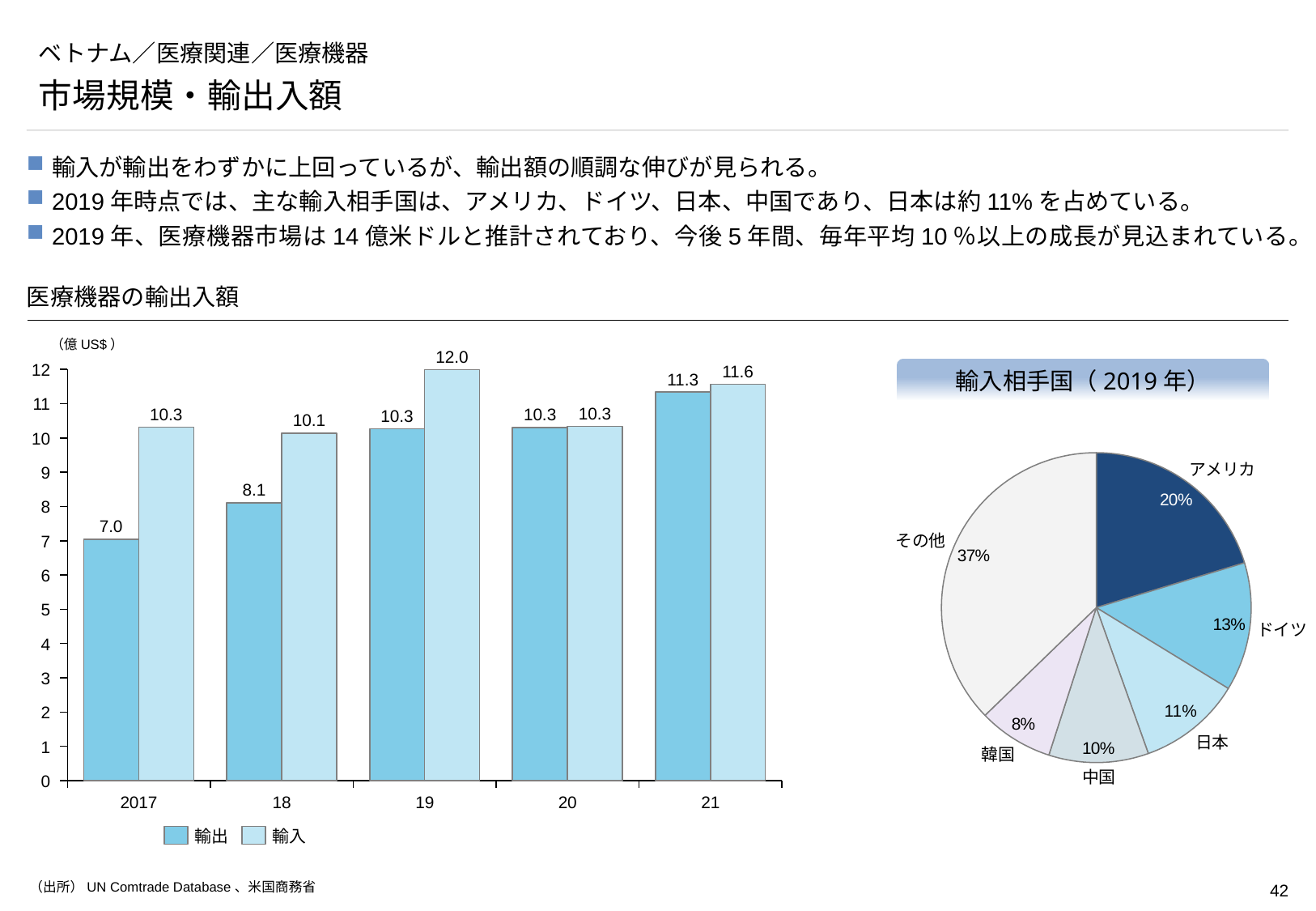
In the bar chart 医療機器の輸出入額, which year has the highest 輸入 value? 19 In the pie chart 輸入相手国（2019年）, which slice is the largest? その他 In the bar chart 医療機器の輸出入額, what is the value of 輸出 for 2017? 7.0 In the bar chart 医療機器の輸出入額, what is the value of 輸入 for 19? 12.0 In the pie chart 輸入相手国（2019年）, how many slices are there? 6 In the bar chart 医療機器の輸出入額, what is the difference between 輸入 and 輸出 in 2017? 3.3 In the bar chart 医療機器の輸出入額, does the 輸出 value rise or fall from 2017 to 21? rise In the bar chart 医療機器の輸出入額, how many series does the legend list? 2 In the pie chart 輸入相手国（2019年）, what share does アメリカ have? 20% In the bar chart 医療機器の輸出入額, what is the value of 輸出 for 21? 11.3 In the bar chart 医療機器の輸出入額, which year has the lowest 輸出 value? 2017 In the pie chart 輸入相手国（2019年）, what share does 日本 have? 11%